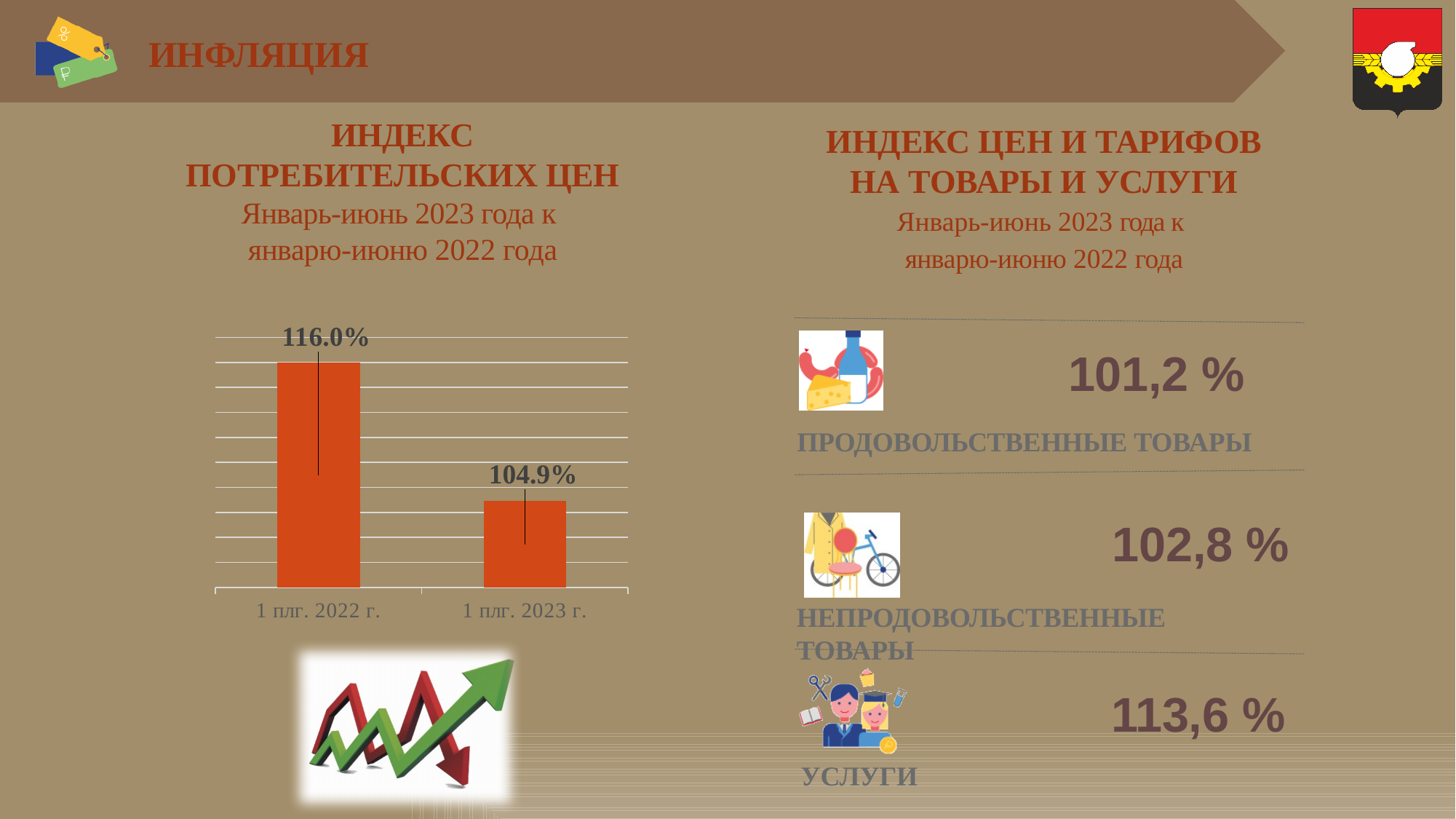
Which category has the highest value in the bar chart? 1 плг. 2022 г. What colour are the bars in the bar chart? Orange What is the value for 1 плг. 2023 г. in the bar chart? 104.9% What is the value for 1 плг. 2022 г. in the bar chart? 116.0% What is the title of the bar chart on the slide? ИНДЕКС ПОТРЕБИТЕЛЬСКИХ ЦЕН What kind of chart is shown on the slide? Bar chart Which is larger in the bar chart: the value for 1 плг. 2022 г. or for 1 плг. 2023 г.? 1 плг. 2022 г. Do the values in the bar chart rise or fall from 1 плг. 2022 г. to 1 плг. 2023 г.? Fall Which category has the lowest value in the bar chart? 1 плг. 2023 г. What is the difference between the values for 1 плг. 2022 г. and 1 плг. 2023 г. in the bar chart? 11.1 percentage points How many categories are shown in the bar chart? 2